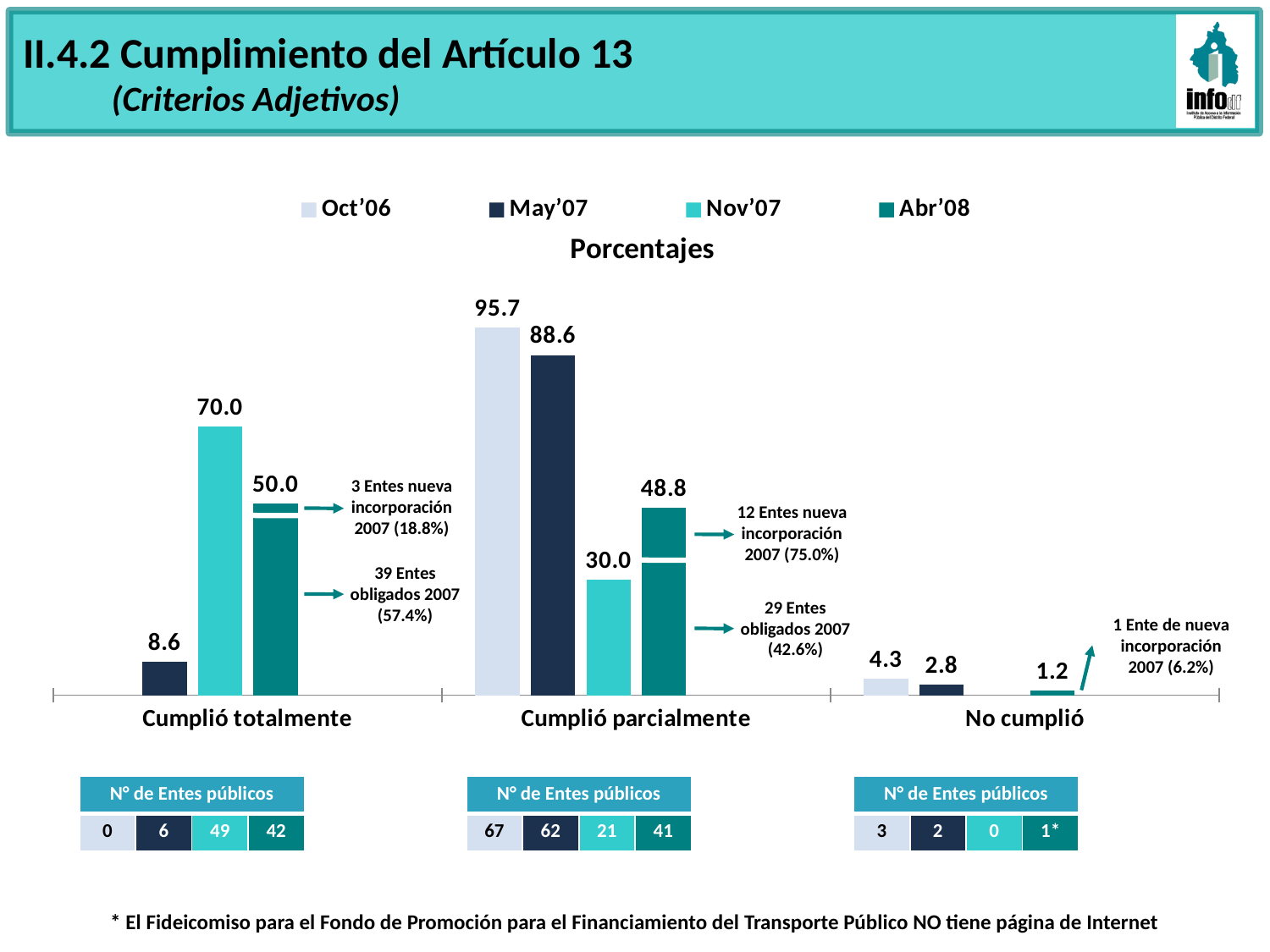
What is the title of the chart? Porcentajes What is the value for Nov'07 in the Cumplió totalmente category? 70.0 Which series has the highest value in the Cumplió parcialmente category? Oct'06 Which series has the lowest labelled value in the No cumplió category? Abr'08 What is the value for May'07 in the Cumplió totalmente category? 8.6 What is the value for Oct'06 in the Cumplió parcialmente category? 95.7 What is the difference between the Nov'07 and Abr'08 values in the Cumplió totalmente category? 20.0 What kind of chart is shown on the slide? Bar chart How many categories are shown on the x axis of the chart? 3 What is the value for Abr'08 in the No cumplió category? 1.2 How many series does the legend list? 4 Which is larger in the Cumplió parcialmente category: the Nov'07 value or the Abr'08 value? Abr'08